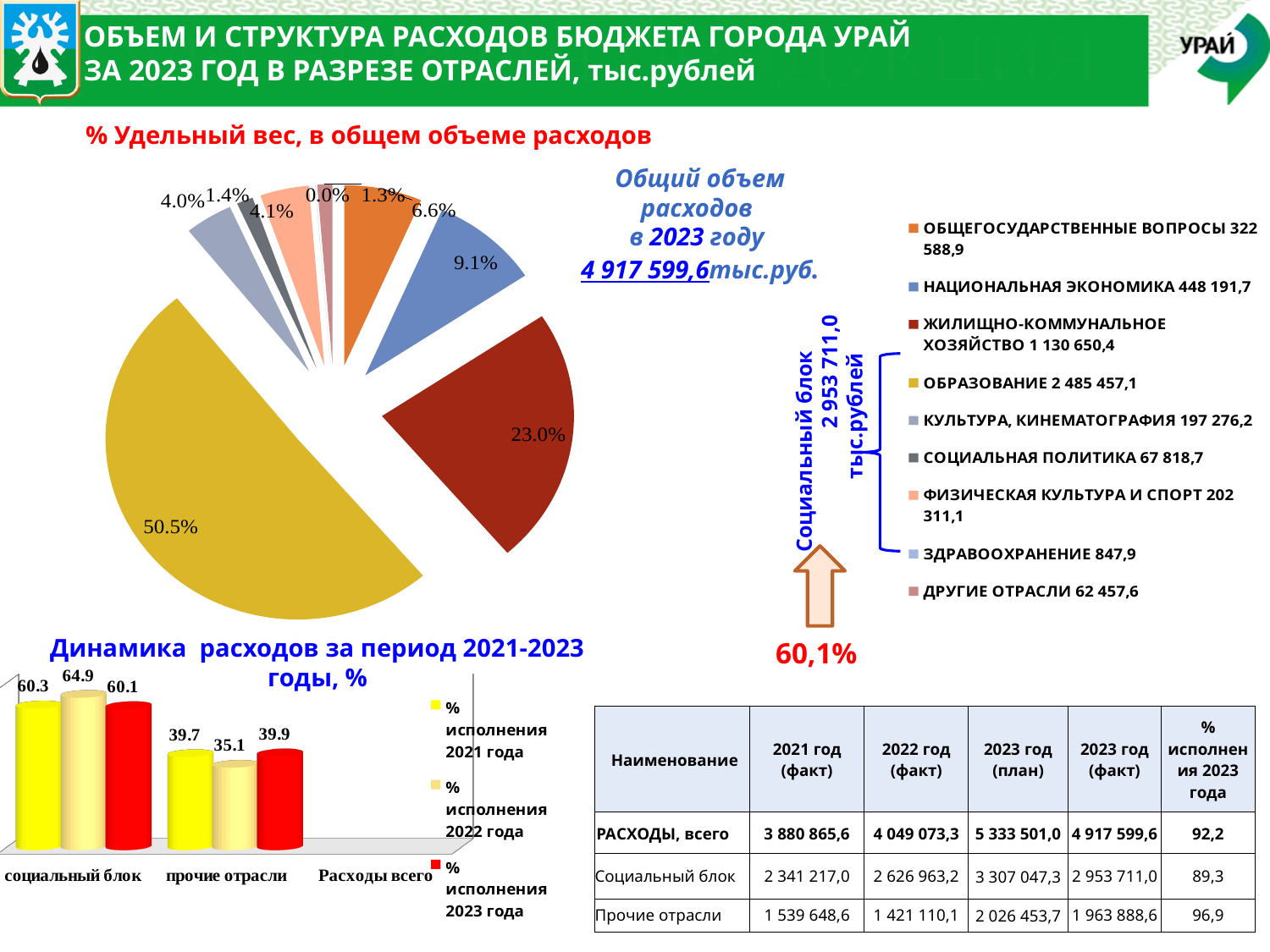
In the pie chart, what is the difference between the legend values for ЖИЛИЩНО-КОММУНАЛЬНОЕ ХОЗЯЙСТВО and НАЦИОНАЛЬНАЯ ЭКОНОМИКА? 682 458,7 In the pie chart, what value does the legend give for ОБРАЗОВАНИЕ? 2 485 457,1 How many series does the legend of the bar chart 'Динамика расходов за период 2021-2023 годы, %' list? 3 In the bar chart 'Динамика расходов за период 2021-2023 годы, %', what is the difference between the 2021 values for социальный блок and прочие отрасли? 20.6 In the bar chart 'Динамика расходов за период 2021-2023 годы, %', what is the value for социальный блок for % исполнения 2022 года? 64.9 In the pie chart '% Удельный вес, в общем объеме расходов', what share is shown for the largest slice? 50.5% How many categories does the legend of the pie chart list? 9 In the pie chart, which is larger: the value for НАЦИОНАЛЬНАЯ ЭКОНОМИКА or for ОБЩЕГОСУДАРСТВЕННЫЕ ВОПРОСЫ? НАЦИОНАЛЬНАЯ ЭКОНОМИКА What kind of chart is 'Динамика расходов за период 2021-2023 годы, %'? bar chart In the pie chart '% Удельный вес, в общем объеме расходов', what percentage label is shown on the dark red slice (ЖИЛИЩНО-КОММУНАЛЬНОЕ ХОЗЯЙСТВО)? 23.0% In the pie chart, what value does the legend give for ЗДРАВООХРАНЕНИЕ? 847,9 In the bar chart 'Динамика расходов за период 2021-2023 годы, %', what is the value for прочие отрасли for % исполнения 2023 года? 39.9